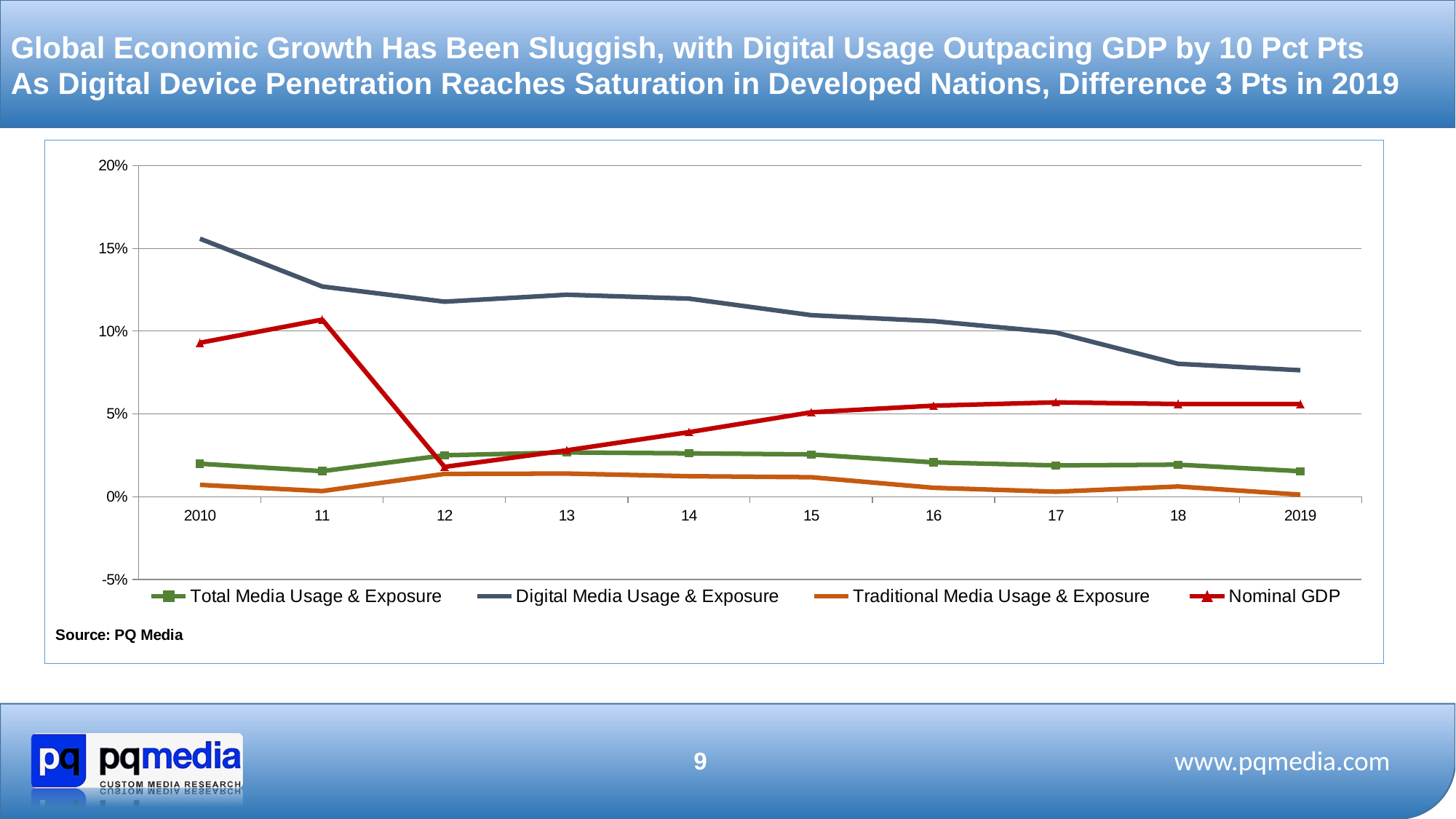
Is the value for Nominal GDP in 2012 greater or less than 5%? less Is the value for Digital Media Usage & Exposure in 2010 greater or less than 10%? greater Is the value for Digital Media Usage & Exposure in 2019 greater or less than 5%? greater Which series has the highest value in 2010? Digital Media Usage & Exposure Which series has the lowest value in 2019? Traditional Media Usage & Exposure In which year is the Digital Media Usage & Exposure line at its highest? 2010 How many series does the legend list? 4 Which is larger in 2011, Nominal GDP or Total Media Usage & Exposure? Nominal GDP How many years are plotted along the x axis? 10 What kind of chart is shown on the slide? Line chart In which year is the Nominal GDP line at its lowest? 2012 Does the Digital Media Usage & Exposure line generally rise or fall from 2010 to 2019? Fall